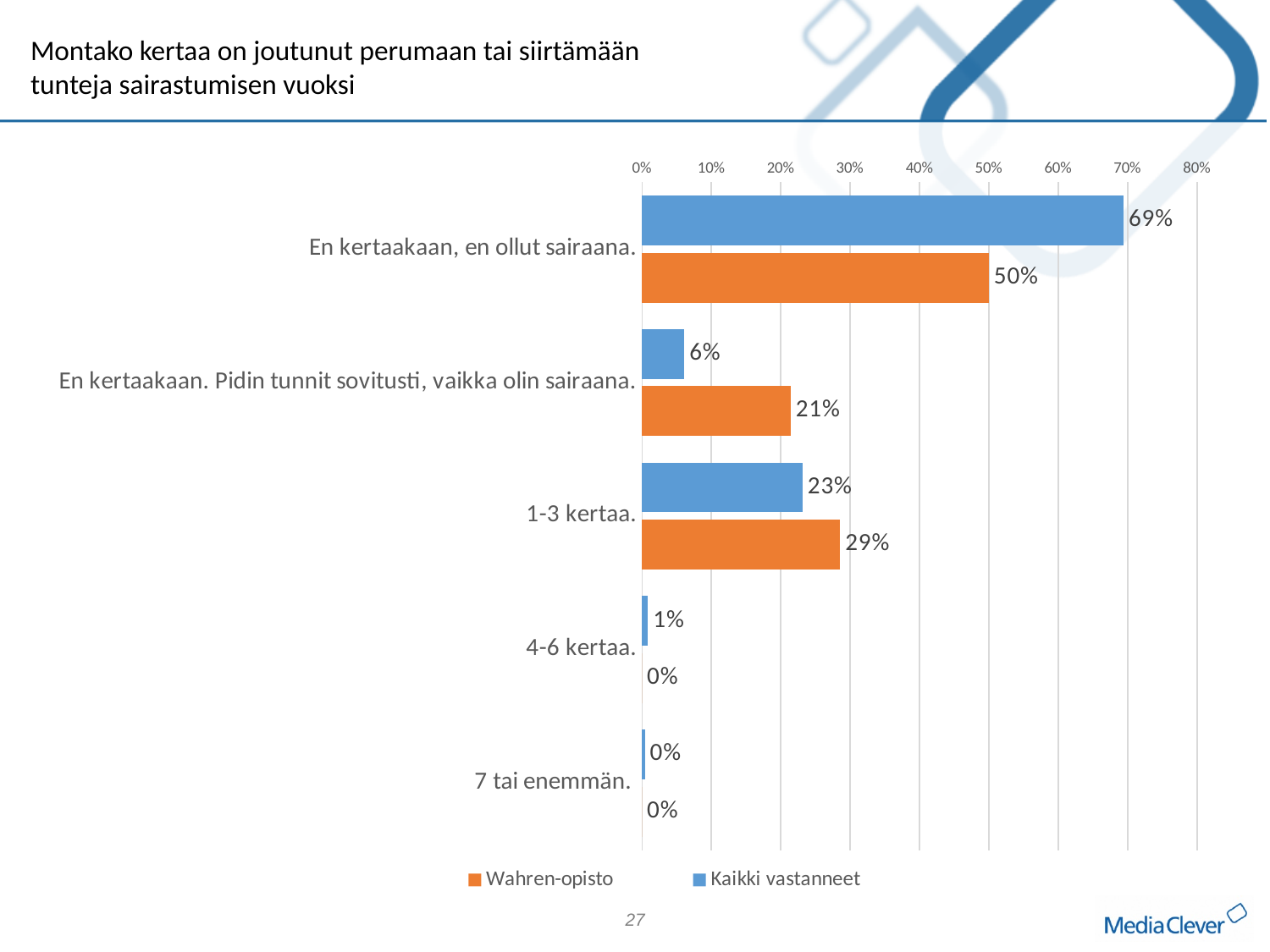
What is the difference between the Kaikki vastanneet and Wahren-opisto values in the category "En kertaakaan, en ollut sairaana."? 19% How many series does the legend list? 2 Which category has the highest value for Wahren-opisto? En kertaakaan, en ollut sairaana. What kind of chart is shown on the slide? bar chart In the category "1-3 kertaa.", which series has the larger value, Wahren-opisto or Kaikki vastanneet? Wahren-opisto How many categories are shown on the chart? 5 Which colour represents the Wahren-opisto series in the chart? orange What is the value for Wahren-opisto in the category "En kertaakaan, en ollut sairaana."? 50% What is the value for Kaikki vastanneet in the category "En kertaakaan, en ollut sairaana."? 69% What is the value for Kaikki vastanneet in the category "1-3 kertaa."? 23% What is the value for Wahren-opisto in the category "En kertaakaan. Pidin tunnit sovitusti, vaikka olin sairaana."? 21% What is the difference between the Wahren-opisto and Kaikki vastanneet values in the category "En kertaakaan. Pidin tunnit sovitusti, vaikka olin sairaana."? 15%